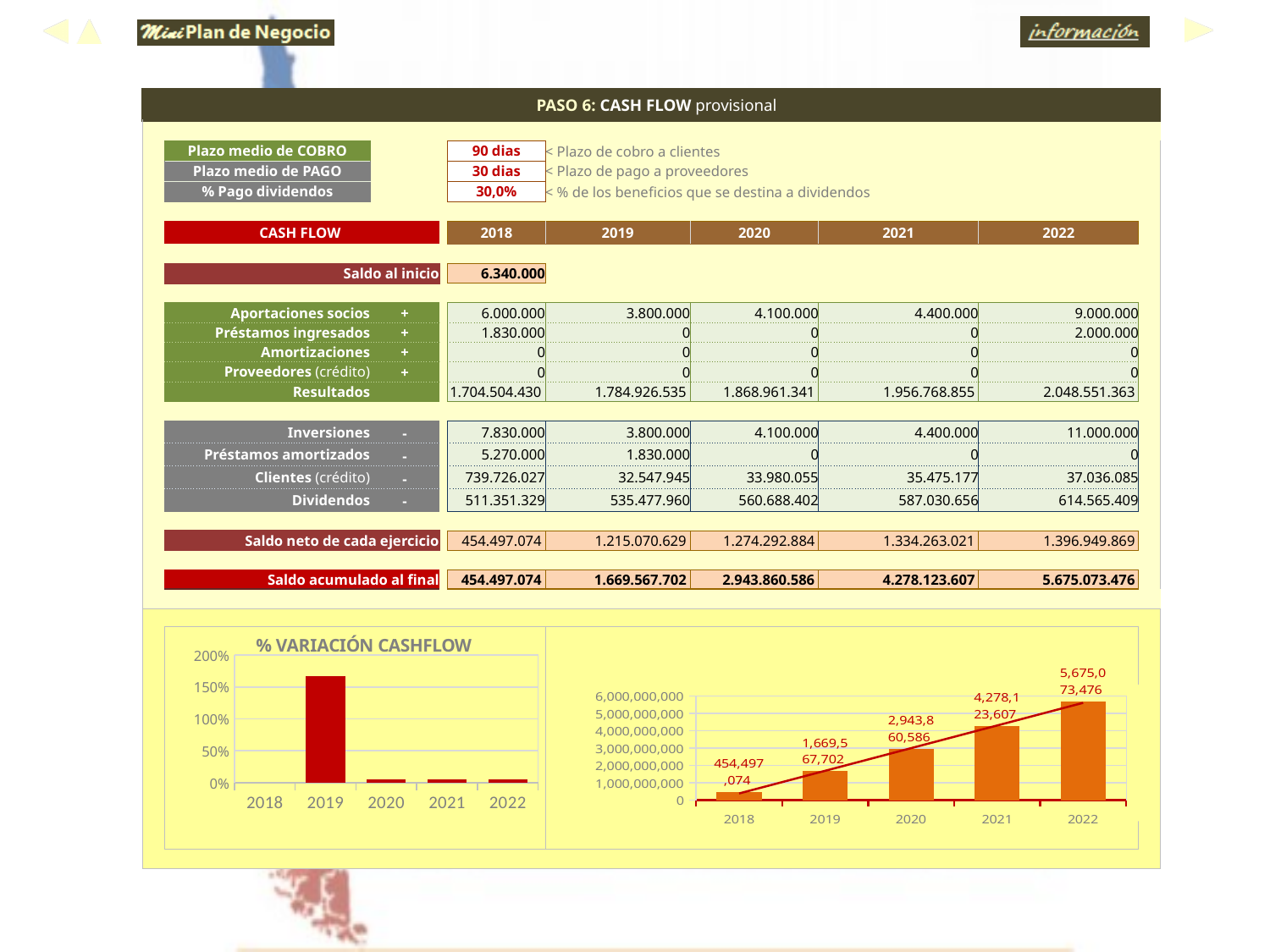
In the '% VARIACIÓN CASHFLOW' chart on the left, is the value for 2019 greater or less than 150%? greater In the '% VARIACIÓN CASHFLOW' chart on the left, which year has the highest value? 2019 In the bar chart on the right of the slide, is the value for 2021 greater or less than 4,000,000,000? greater In the '% VARIACIÓN CASHFLOW' chart on the left, is the value for 2020 greater or less than 50%? less In the bar chart on the right of the slide, do the values rise or fall from 2018 to 2022? rise What type of chart is the '% VARIACIÓN CASHFLOW' chart on the left? bar chart In the bar chart on the right of the slide, which year has the lowest value? 2018 In the bar chart on the right of the slide, what is the value for 2020? 2,943,860,586 In the bar chart on the right of the slide, which is larger, the value for 2019 or the value for 2021? 2021 How many years are shown on the x axis of the '% VARIACIÓN CASHFLOW' chart on the left? 5 In the bar chart on the right of the slide, what is the value for 2018? 454,497,074 In the bar chart on the right of the slide, what is the value for 2022? 5,675,073,476